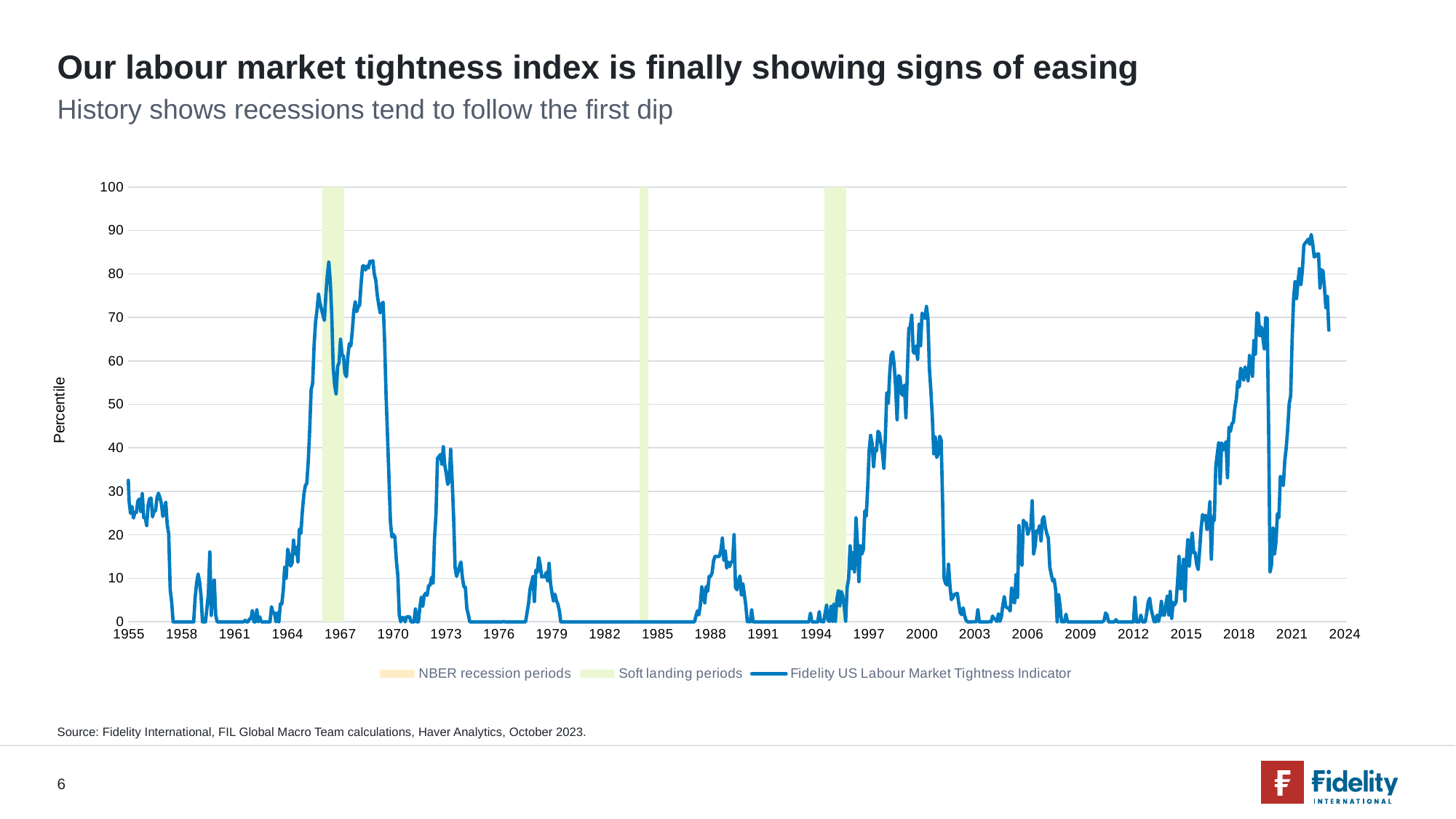
How many green 'Soft landing periods' bands are shaded on the chart? 3 How many entries does the chart legend list? 3 Is the peak value of the Fidelity US Labour Market Tightness Indicator around 2022 greater or less than 80? greater Is the value of the Fidelity US Labour Market Tightness Indicator in 1982 greater or less than 10? less What is the label on the vertical axis of the chart? Percentile Which is higher, the indicator's peak around 2022 or its peak around 2000? the peak around 2022 What kind of chart is shown on the slide? line chart Is the value of the indicator at the start of the series in 1955 greater or less than 20? greater From its peak around 2022 to the end of the series, is the indicator rising or falling? falling What is the title of the slide containing the chart? Our labour market tightness index is finally showing signs of easing